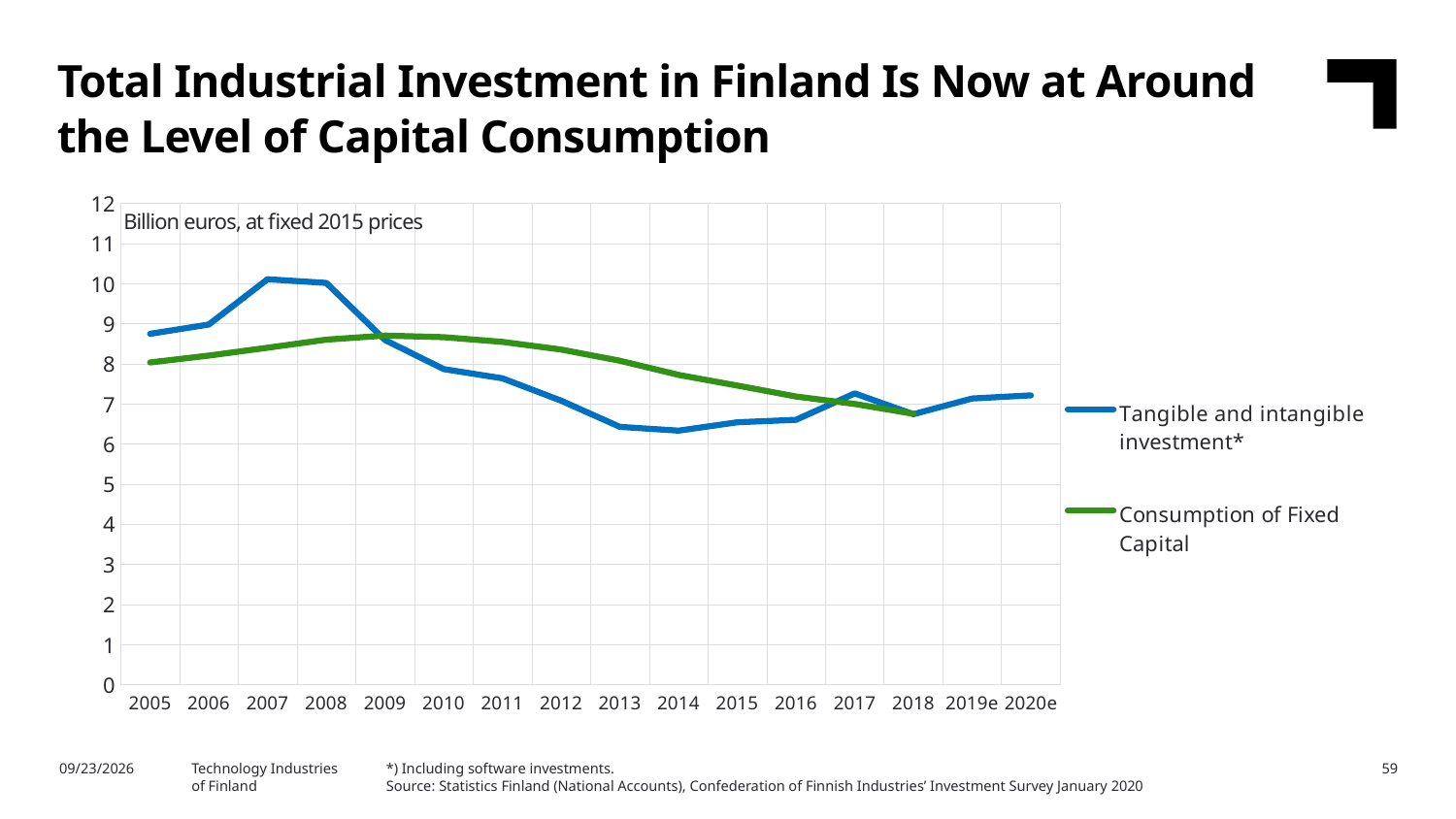
Which colour is used for the Consumption of Fixed Capital line? green In 2012, which series has the higher value: Tangible and intangible investment* or Consumption of Fixed Capital? Consumption of Fixed Capital Is the value for Tangible and intangible investment* in 2007 greater or less than 9? greater Does the Consumption of Fixed Capital line rise or fall from 2009 to 2018? fall Is the value for Consumption of Fixed Capital in 2012 greater or less than 8? greater Is the value for Tangible and intangible investment* in 2014 greater or less than 7? less In 2007, which series has the higher value: Tangible and intangible investment* or Consumption of Fixed Capital? Tangible and intangible investment* How many years are shown on the x axis? 16 How many series does the legend list? 2 What unit is stated in the label inside the chart area? Billion euros, at fixed 2015 prices What kind of chart is shown on the slide? line chart